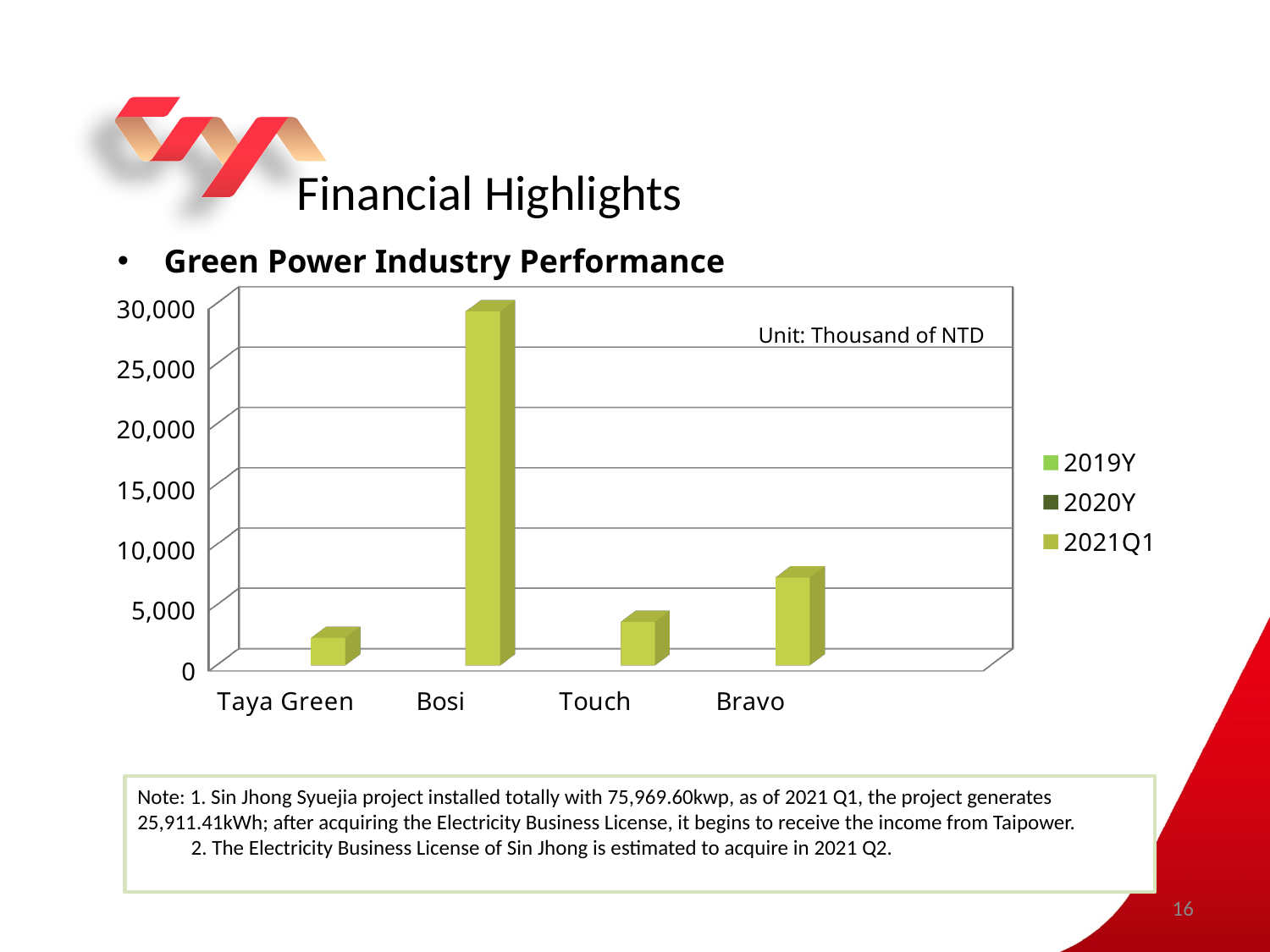
Is the value for Touch greater or less than 5,000? less What kind of chart is shown on the slide? Bar chart What unit is stated for the values in the chart? Thousand of NTD How many series does the chart's legend list? 3 Is the value for Taya Green greater or less than 5,000? less What are the three entries listed in the chart's legend? 2019Y, 2020Y, 2021Q1 Is the value for Bravo greater or less than 10,000? less Which is larger, the value for Bravo or the value for Touch? Bravo Which category has the lowest bar in the chart? Taya Green Which category has the highest bar in the chart? Bosi How many categories are shown on the x axis of the chart? 4